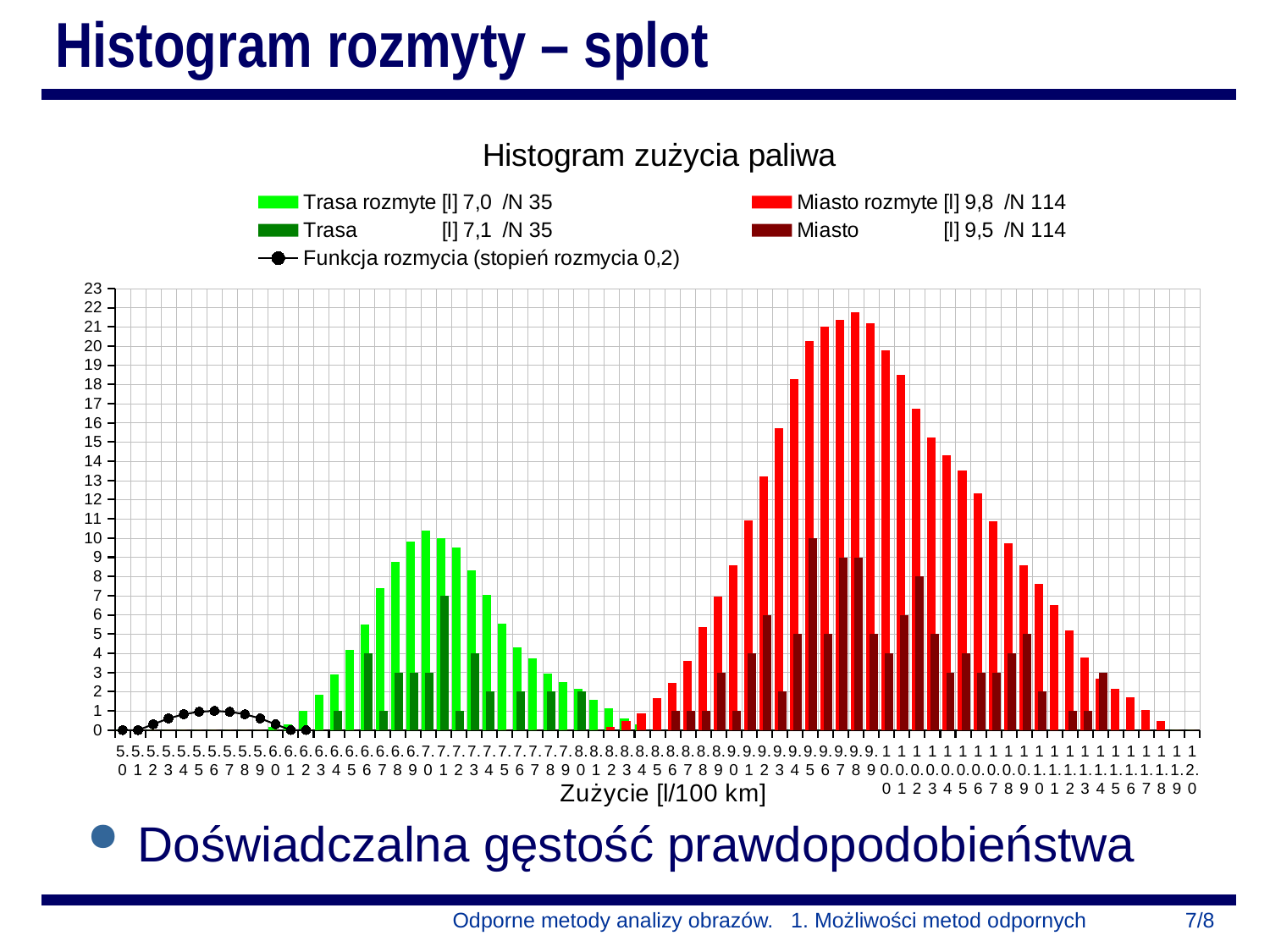
According to the legend, what is the [l] value for Trasa rozmyte? 7,0 Is the highest value of the Funkcja rozmycia line greater or less than 2? less Is the highest value of the Trasa rozmyte series greater or less than 15? less How many series does the legend list? 5 What type of chart is shown on the slide? bar chart Which series reaches the highest value on the chart? Miasto rozmyte What is the label of the x axis? Zużycie [l/100 km] Which is larger, the peak of Trasa rozmyte or the peak of Miasto rozmyte? Miasto rozmyte What is the stopień rozmycia given in the legend for Funkcja rozmycia? 0,2 Is the highest value of the Miasto rozmyte series greater or less than 20? greater According to the legend, what is the N value for the Miasto series? 114 What is the title of the chart? Histogram zużycia paliwa